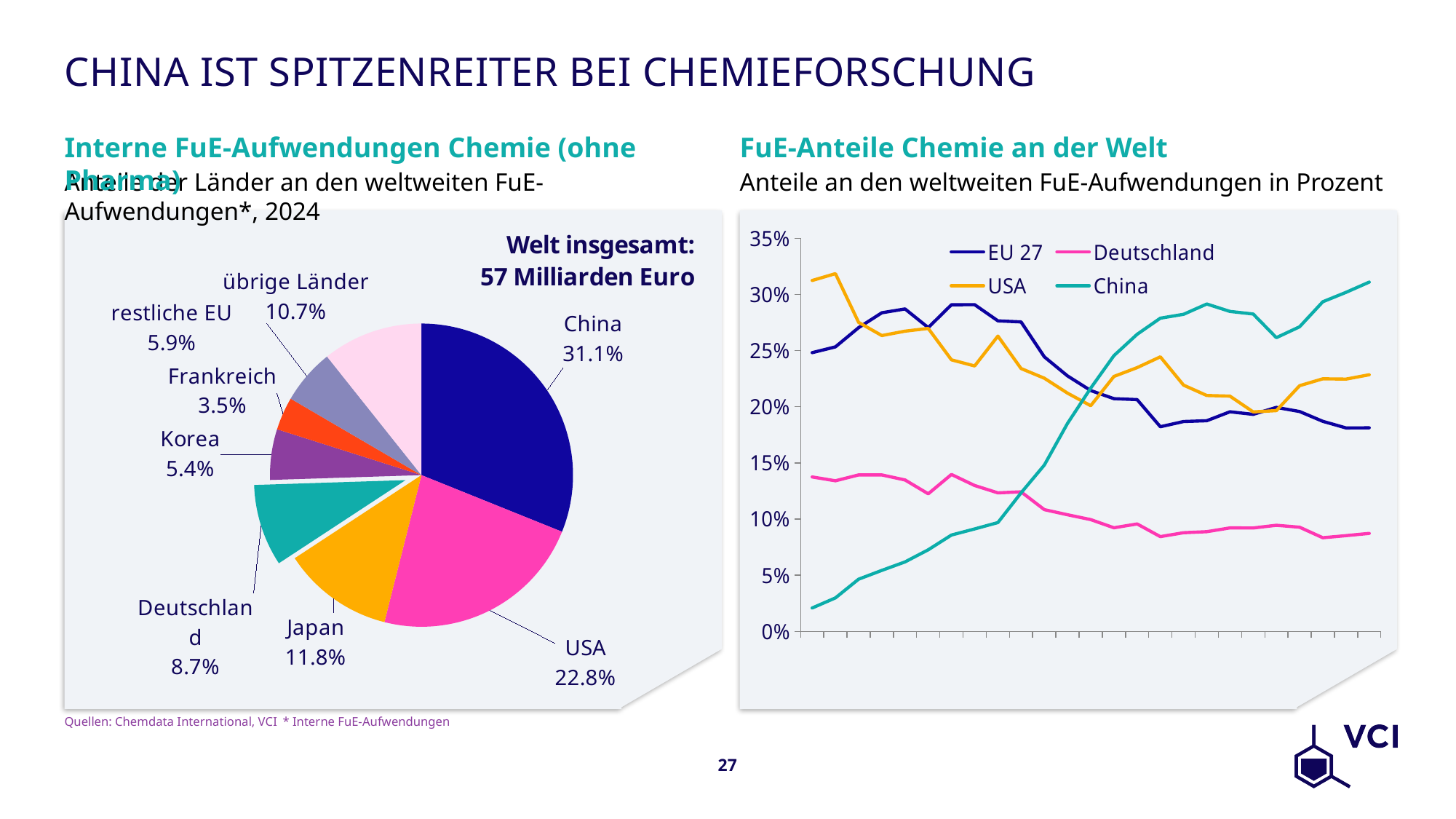
On the chart 'FuE-Anteile Chemie an der Welt', does the China line rise or fall along the x axis? rise On the pie chart 'Interne FuE-Aufwendungen Chemie (ohne Pharma)', what is the difference in percentage points between the shares of China and the USA? 8.3 On the chart 'FuE-Anteile Chemie an der Welt', is the final value of the Deutschland line greater or less than 10%? less On the pie chart 'Interne FuE-Aufwendungen Chemie (ohne Pharma)', which labelled slice is the smallest? Frankreich On the pie chart 'Interne FuE-Aufwendungen Chemie (ohne Pharma)', which has the larger share, Korea or restliche EU? restliche EU How many series does the legend of the chart 'FuE-Anteile Chemie an der Welt' list? 4 What kind of chart is 'FuE-Anteile Chemie an der Welt'? line chart On the pie chart 'Interne FuE-Aufwendungen Chemie (ohne Pharma)', what share does China have? 31.1% On the pie chart 'Interne FuE-Aufwendungen Chemie (ohne Pharma)', what share does Japan have? 11.8% On the pie chart 'Interne FuE-Aufwendungen Chemie (ohne Pharma)', what is the total world value stated on the chart? 57 Milliarden Euro On the pie chart 'Interne FuE-Aufwendungen Chemie (ohne Pharma)', which country has the largest share? China How many slices does the pie chart 'Interne FuE-Aufwendungen Chemie (ohne Pharma)' have? 8